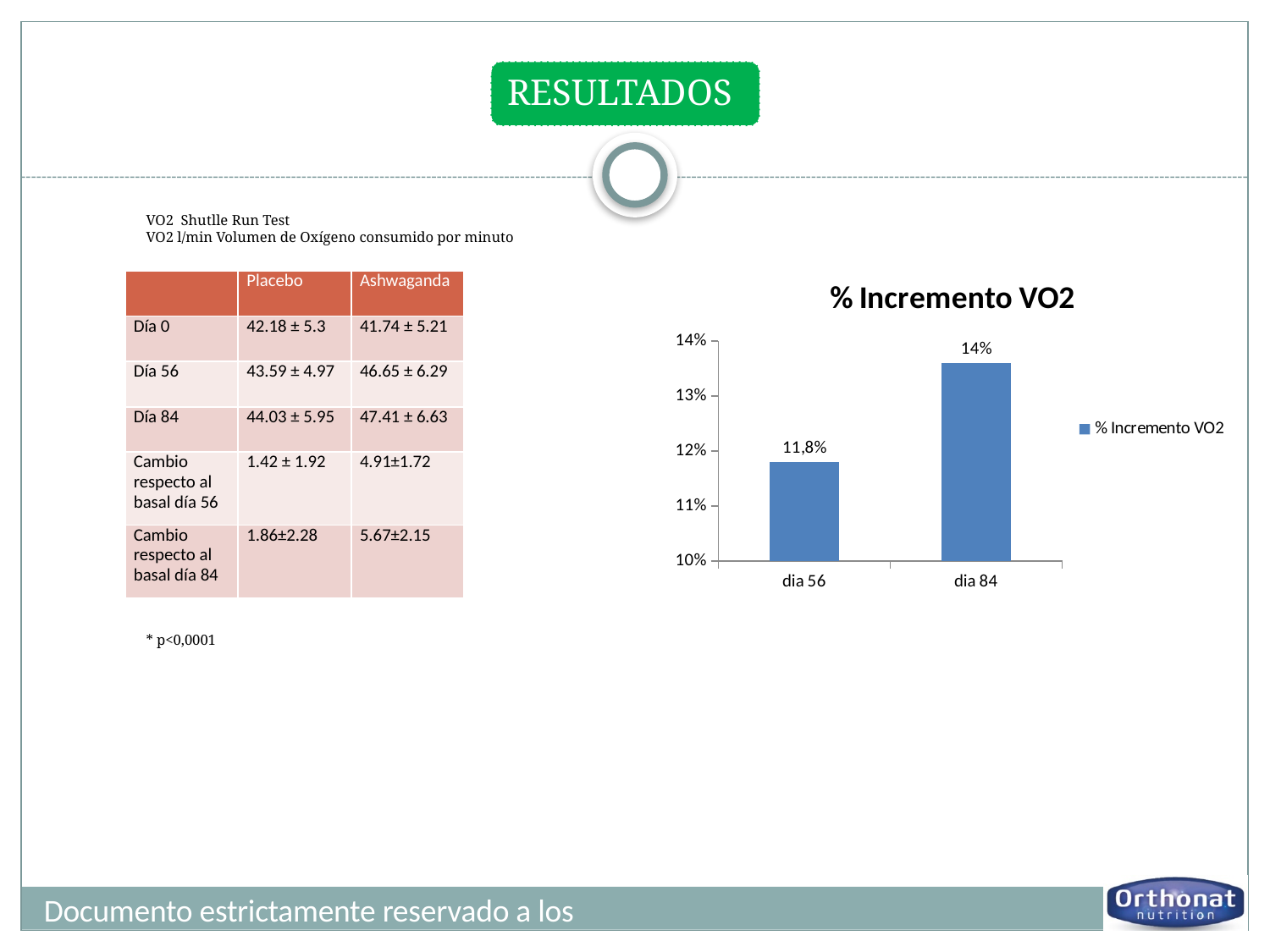
Do the values in the % Incremento VO2 chart rise or fall from dia 56 to dia 84? rise What is the value for dia 84 in the % Incremento VO2 chart? 14% Is the value for dia 56 in the % Incremento VO2 chart greater or less than 12%? less What kind of chart is the % Incremento VO2 chart? bar chart What is the title of the chart on the slide? % Incremento VO2 Is the value for dia 84 in the % Incremento VO2 chart greater or less than 13%? greater Which category has the highest value in the % Incremento VO2 chart? dia 84 What is the value for dia 56 in the % Incremento VO2 chart? 11,8% How many series does the legend of the % Incremento VO2 chart list? 1 Which is larger in the % Incremento VO2 chart, dia 56 or dia 84? dia 84 Which category has the lowest value in the % Incremento VO2 chart? dia 56 How many categories are shown on the x axis of the % Incremento VO2 chart? 2